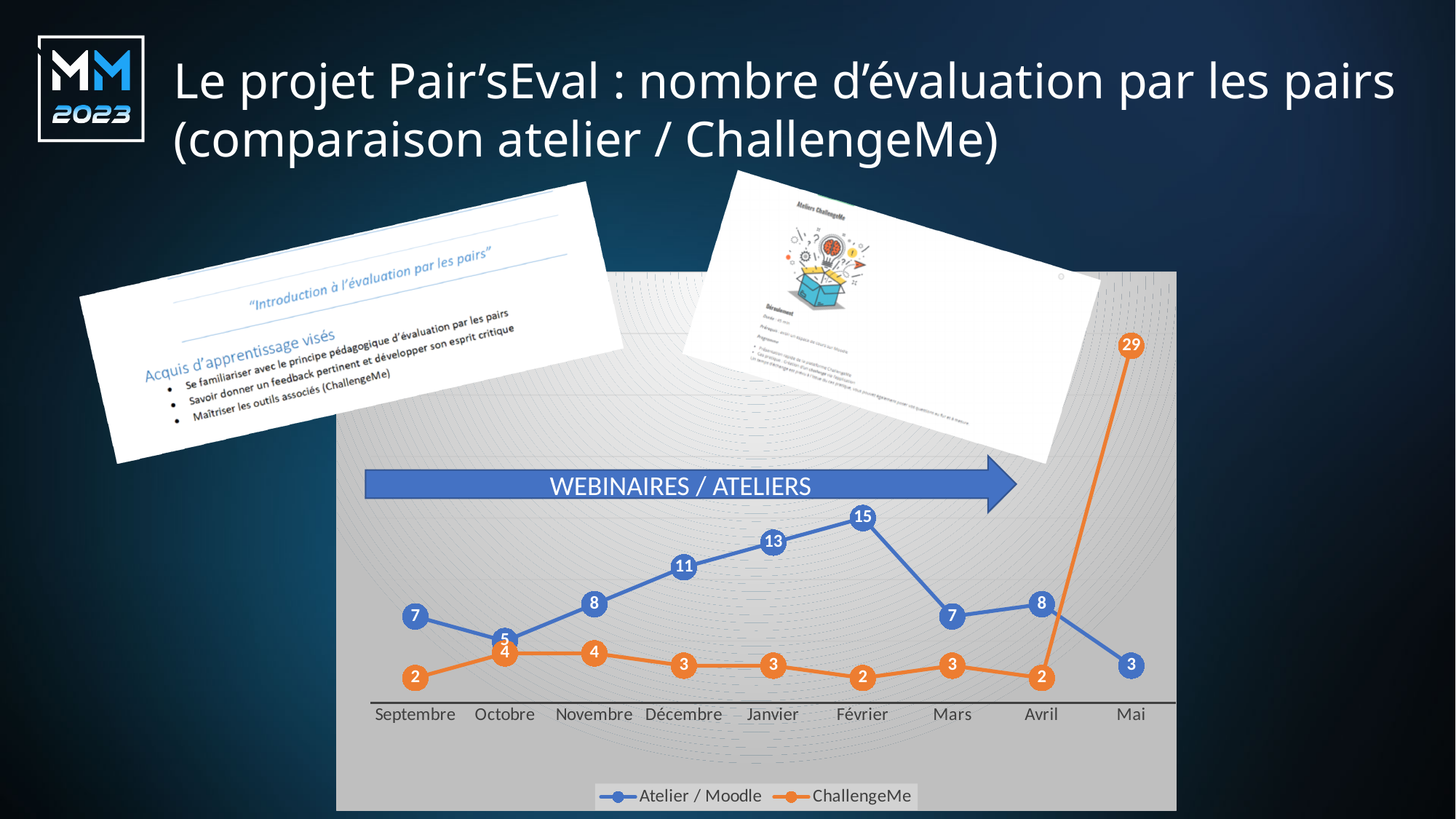
In which month is the Atelier / Moodle series lowest? Mai What is the value for ChallengeMe in Mai? 29 What is the value for Atelier / Moodle in Février? 15 Does the Atelier / Moodle series rise or fall from Octobre to Février? Rise Which series has the larger value in Mai, Atelier / Moodle or ChallengeMe? ChallengeMe In which month is the Atelier / Moodle series highest? Février Which series is drawn in orange? ChallengeMe What is the difference between Atelier / Moodle and ChallengeMe in Janvier? 10 What type of chart is shown on the slide? Line chart What is the value for ChallengeMe in Octobre? 4 How many series does the legend list? 2 How many months are shown on the x axis? 9